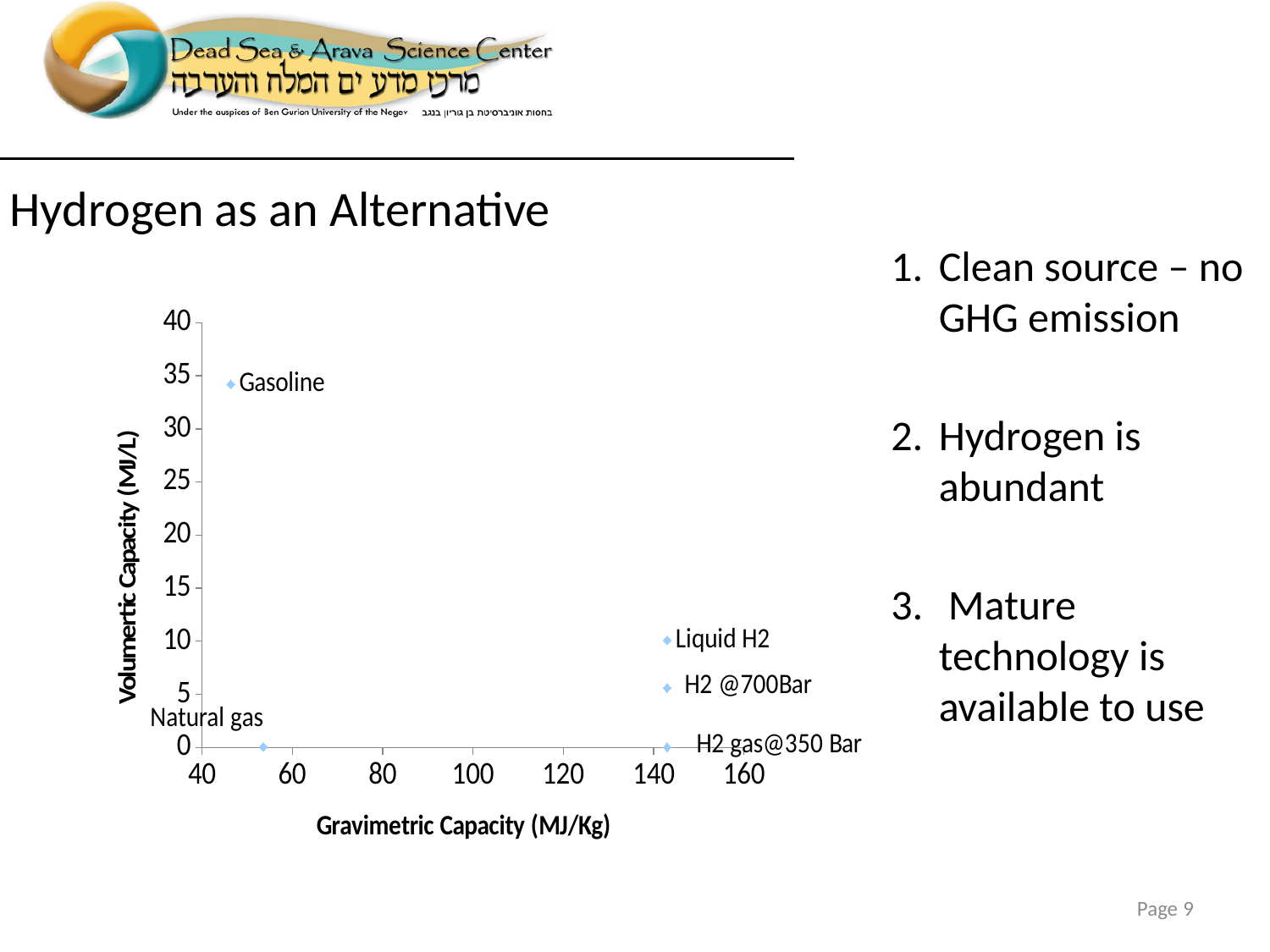
What is the title of the x axis of the chart? Gravimetric Capacity (MJ/Kg) What is the title of the y axis of the chart? Volumertic Capacity (MJ/L) Which has the higher gravimetric capacity, Gasoline or Liquid H2? Liquid H2 What kind of chart is shown on the slide? scatter chart Is the gravimetric capacity for Gasoline greater or less than 60? less Is the volumetric capacity for Gasoline greater or less than 30? greater How many data points are plotted on the chart? 5 Which has the higher volumetric capacity, Liquid H2 or H2 @700Bar? Liquid H2 Is the volumetric capacity for H2 @700Bar greater or less than 10? less Which point has the highest volumetric capacity? Gasoline